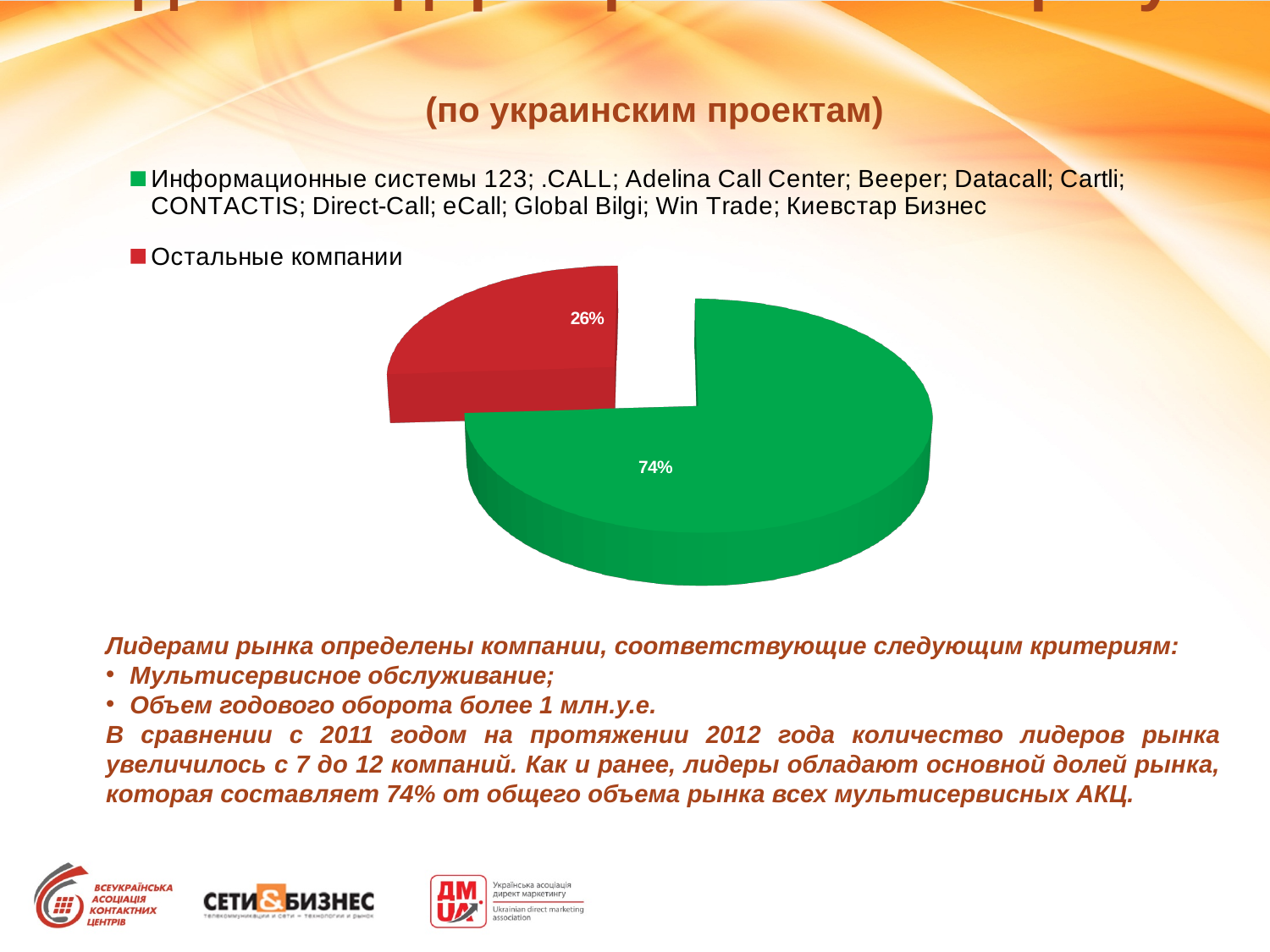
What colour is the 74% slice? green Which is larger: the share for the leader companies or the share for "Остальные компании"? the leader companies What share of the pie does the slice for "Остальные компании" represent? 26% How many entries does the legend list? 2 Is the share for "Остальные компании" greater or less than 50%? less What is the difference in percentage points between the green slice (74%) and the red slice (26%)? 48 Which slice of the pie is the smallest? Остальные компании What share of the pie does the green slice (the list of leader companies starting with "Информационные системы 123") represent? 74% What colour is the slice for "Остальные компании"? red How many slices does the pie chart have? 2 Which slice of the pie is the largest? Информационные системы 123; .CALL; Adelina Call Center; Beeper; Datacall; Cartli; CONTACTIS; Direct-Call; eCall; Global Bilgi; Win Trade; Киевстар Бизнес What kind of chart is shown on the slide? pie chart